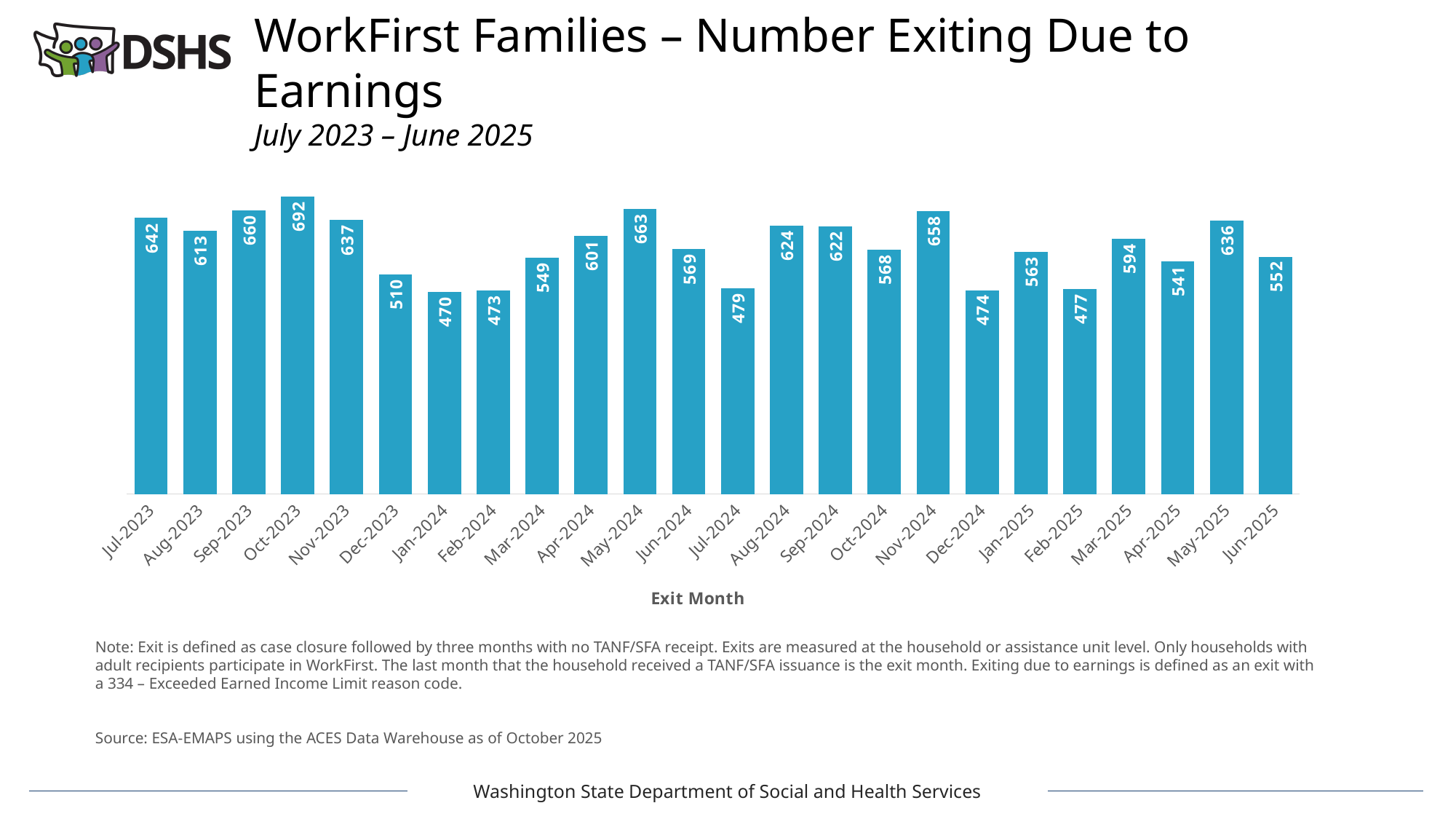
Which exit month has the lowest number of families exiting due to earnings? Jan-2024 What is the value shown for Jun-2025? 552 Which exit month has the highest number of families exiting due to earnings? Oct-2023 What is the label of the x axis? Exit Month Which is larger, the value for Nov-2024 or the value for Dec-2024? Nov-2024 How many exit months are plotted on the chart? 24 What is the value shown for Jan-2024? 470 What kind of chart is shown on the slide? Bar chart What is the difference between the values for May-2025 and Apr-2025? 95 What is the number of WorkFirst families exiting due to earnings in Oct-2023? 692 What is the difference between the values for Oct-2023 and Jan-2024? 222